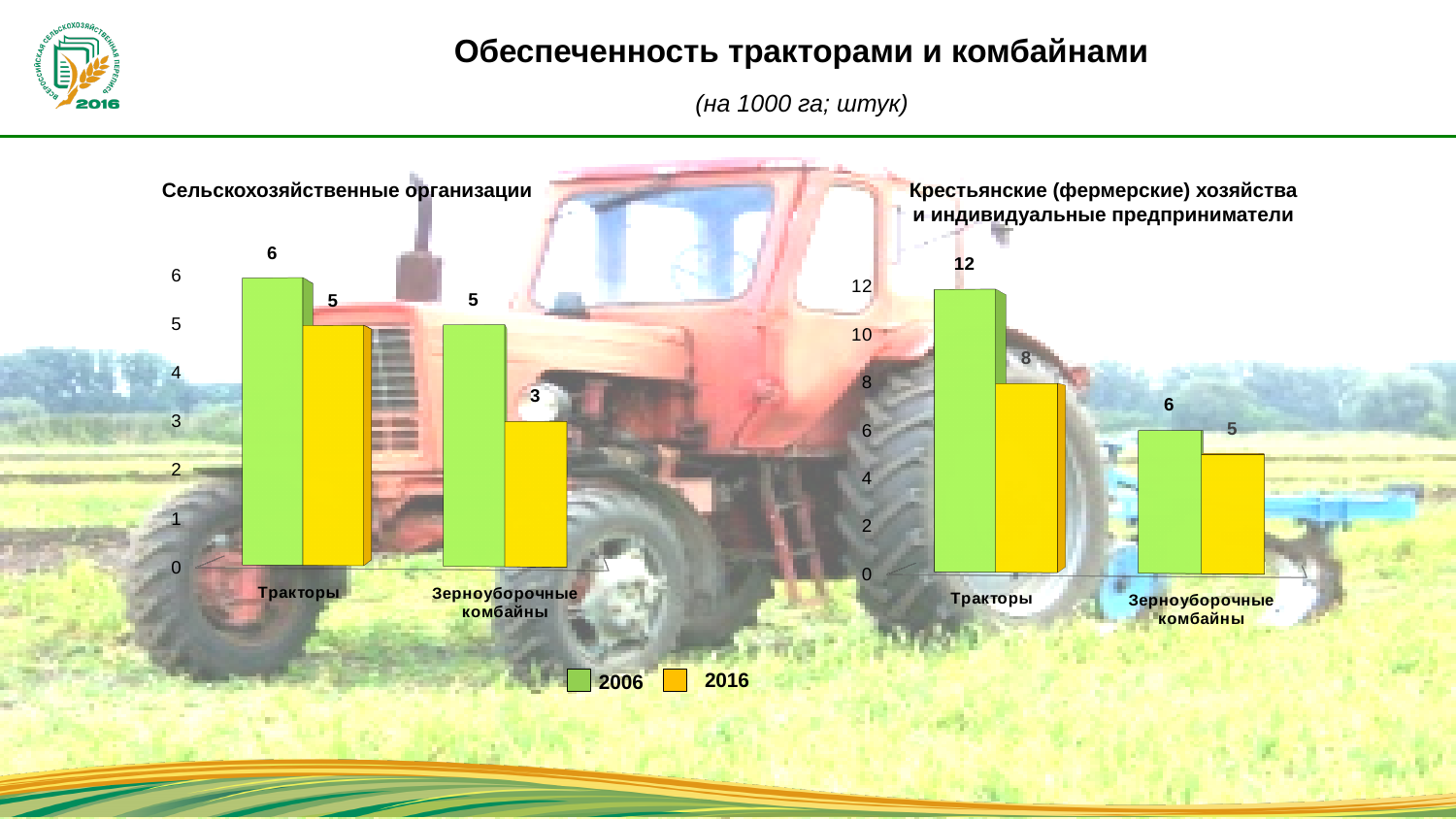
In the chart titled "Крестьянские (фермерские) хозяйства и индивидуальные предприниматели", what is the difference between the 2006 and 2016 values for Тракторы? 4 In the chart titled "Сельскохозяйственные организации", which is larger for Тракторы: the 2006 value or the 2016 value? 2006 How many series does the legend list for the charts on the slide? 2 In the chart titled "Сельскохозяйственные организации", by how much did the value for Зерноуборочные комбайны change from 2006 to 2016? 2 In the chart titled "Крестьянские (фермерские) хозяйства и индивидуальные предприниматели", what is the value for Тракторы in 2006? 12 What kind of chart is the chart titled "Крестьянские (фермерские) хозяйства и индивидуальные предприниматели"? Bar chart In the chart titled "Крестьянские (фермерские) хозяйства и индивидуальные предприниматели", which category has the highest value in 2006? Тракторы Which colour represents the 2016 series in the charts on the slide? Yellow In the chart titled "Сельскохозяйственные организации", which category has the lowest value in 2016? Зерноуборочные комбайны In the chart titled "Крестьянские (фермерские) хозяйства и индивидуальные предприниматели", what is the value for Зерноуборочные комбайны in 2016? 5 In the chart titled "Сельскохозяйственные организации", what is the value for Зерноуборочные комбайны in 2016? 3 In the chart titled "Сельскохозяйственные организации", what is the value for Тракторы in 2006? 6